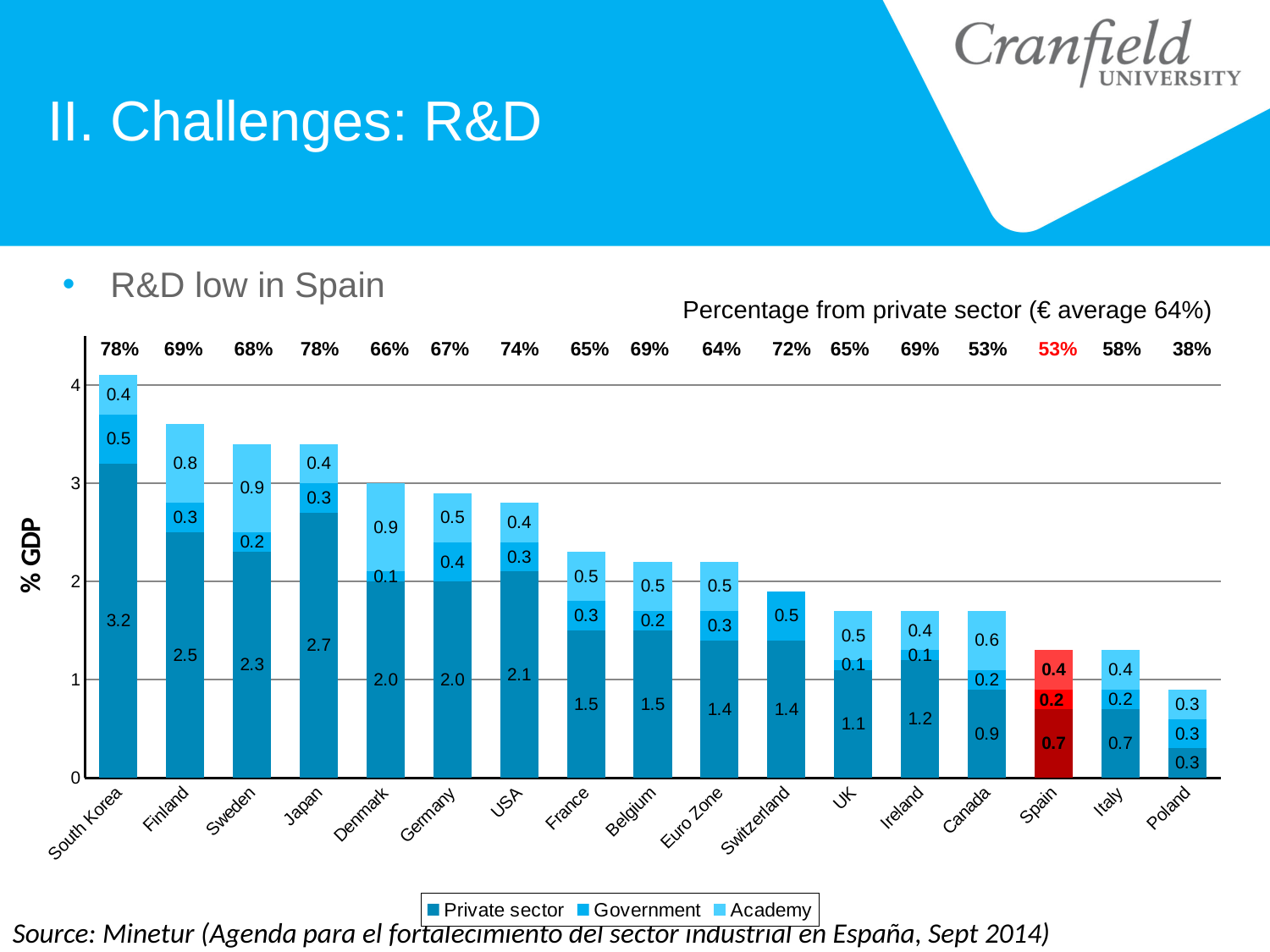
What is the difference between the Private sector values for South Korea and Spain? 2.5 Which has the larger Private sector value, Japan or Finland? Japan Which country has the lowest Private sector value? Poland Which country's bar is highlighted in red? Spain What is the total of the stacked bar for Spain? 1.3 What is the Academy value for Sweden? 0.9 Which country has the highest Private sector value? South Korea How many series does the legend list? 3 What kind of chart is shown on the slide? Stacked bar chart How many countries or regions are shown on the x axis? 17 What is the Private sector value for Spain? 0.7 What percentage from the private sector is shown above the bar for Poland? 38%